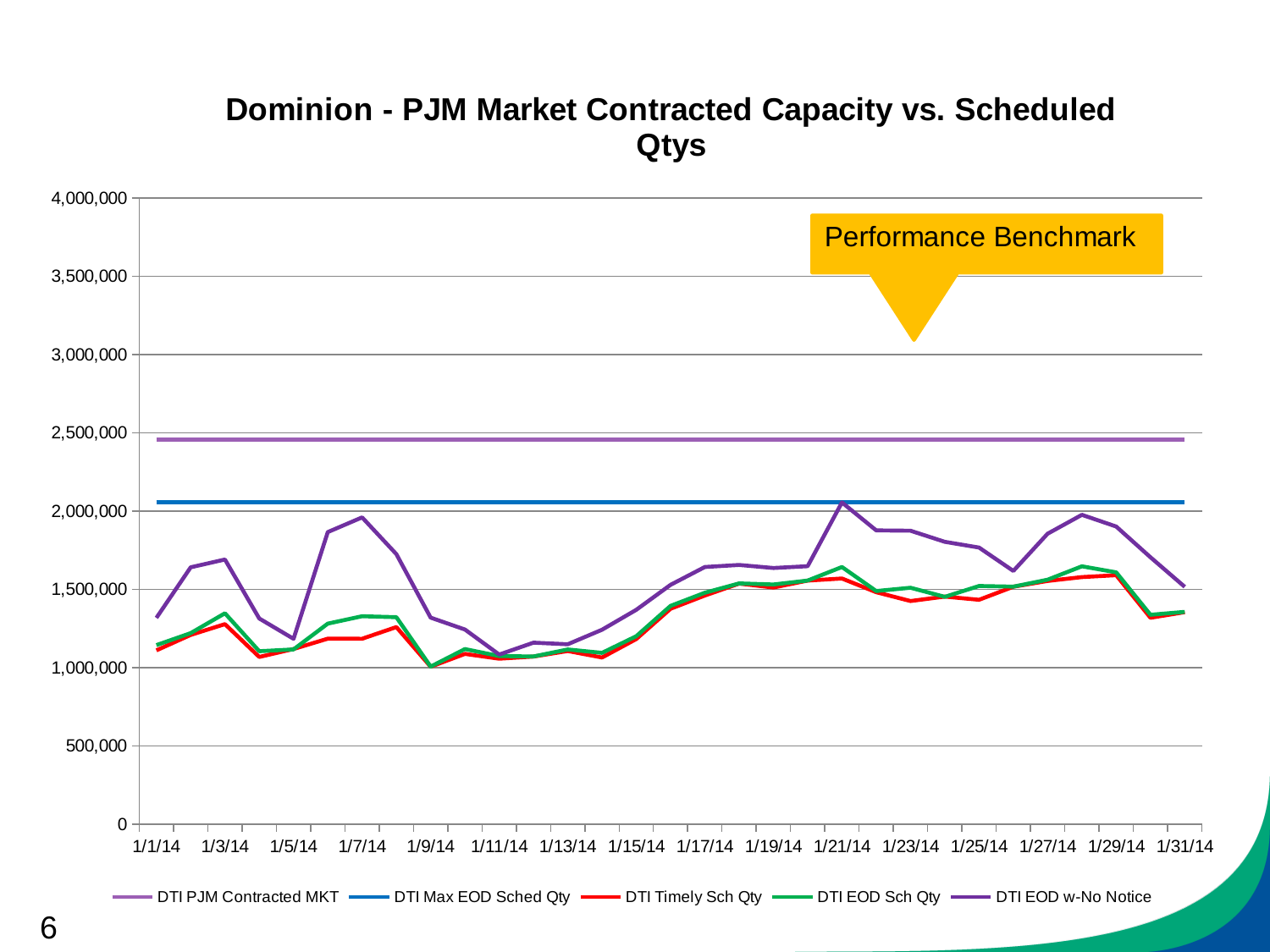
Which is larger, DTI PJM Contracted MKT or DTI Max EOD Sched Qty? DTI PJM Contracted MKT What is the title of the chart? Dominion - PJM Market Contracted Capacity vs. Scheduled Qtys How many series does the legend list? 5 Is the value of DTI EOD w-No Notice on 1/7/14 greater or less than 2,000,000? less Is the value of DTI PJM Contracted MKT greater or less than 2,500,000? less Is the value of DTI Timely Sch Qty on 1/1/14 greater or less than 1,000,000? greater What kind of chart is shown on the slide? Line chart Which series has the highest values across the whole chart? DTI PJM Contracted MKT On which date does DTI EOD w-No Notice reach its highest value? 1/21/14 What text appears in the callout box above the chart lines? Performance Benchmark Does DTI EOD w-No Notice rise or fall from 1/29/14 to 1/31/14? fall